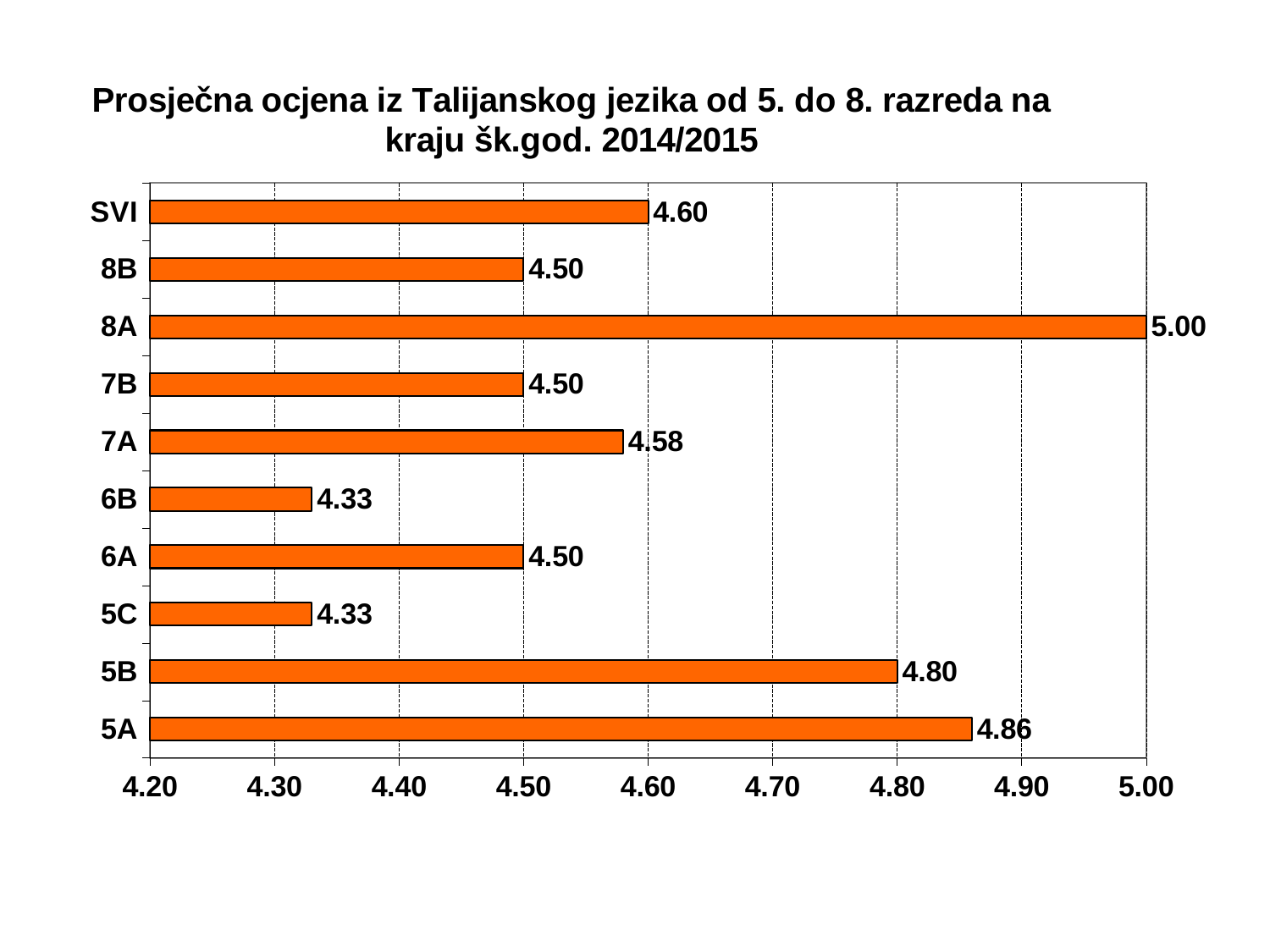
Is the value for 5B greater or less than 4.70? greater What kind of chart is this? bar chart What is the difference between the value for 8A and the value for SVI? 0.40 What is the average grade for class 7A? 4.58 What is the value shown for SVI? 4.60 How many bars are shown in the chart? 10 What is the difference between the values for 5A and 5B? 0.06 What is the average grade for class 8A? 5.00 Which is larger, the value for 7A or the value for 7B? 7A Which class has the highest average grade? 8A What colour are the bars in the chart? orange Which classes share the lowest average grade of 4.33? 6B and 5C